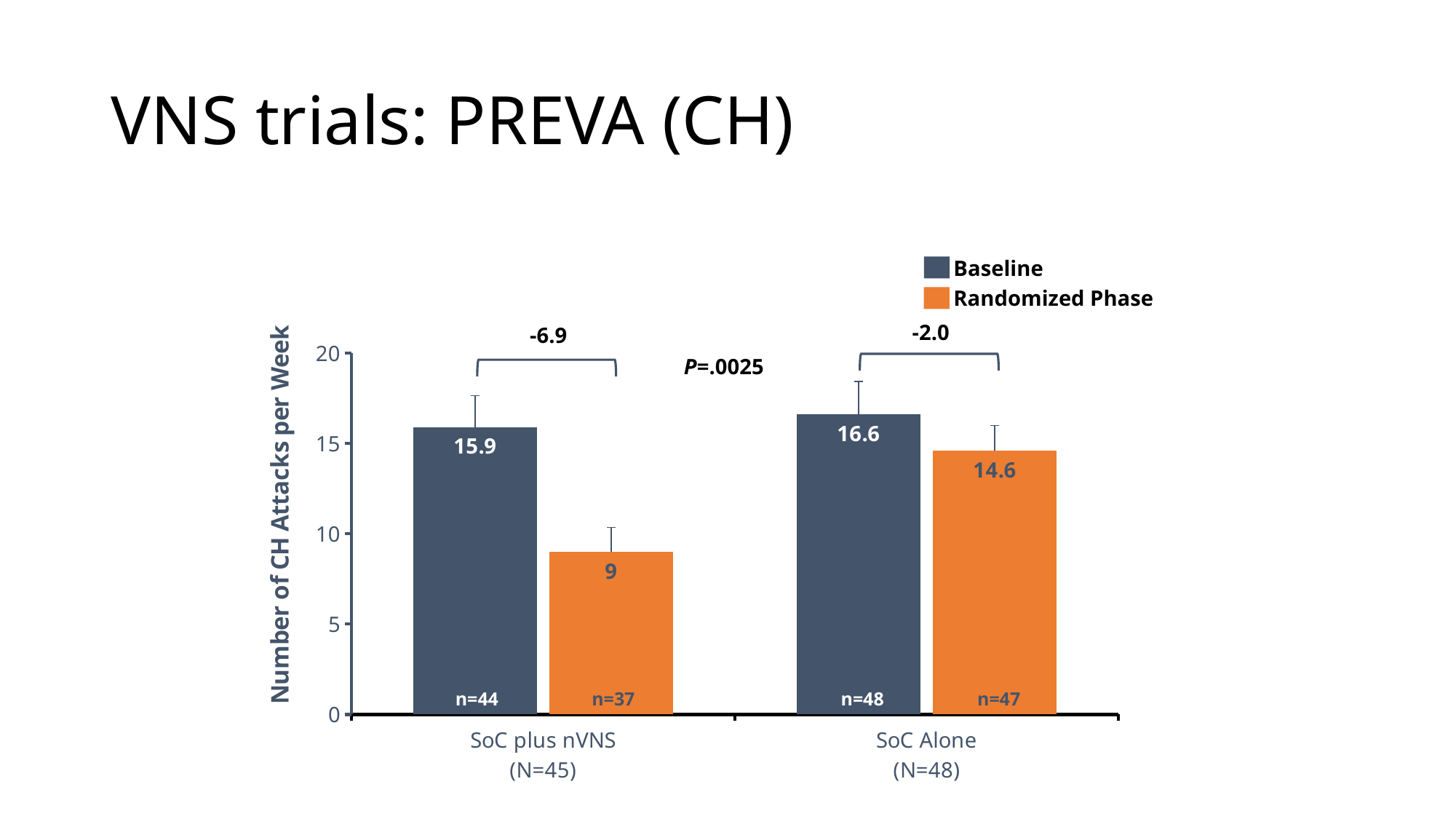
What is the Baseline value for SoC Alone? 16.6 How many series does the legend list? 2 How many categories are shown on the x axis? 2 What is the y-axis label of the chart? Number of CH Attacks per Week Which bar has the lowest value on the chart? Randomized Phase for SoC plus nVNS What is the Randomized Phase value for SoC Alone? 14.6 What is the Baseline value for SoC plus nVNS? 15.9 What is the difference between the Baseline and Randomized Phase values for SoC plus nVNS? 6.9 Which is larger: the Randomized Phase value for SoC Alone or the Randomized Phase value for SoC plus nVNS? SoC Alone What kind of chart is shown on the slide? Bar chart Which bar has the highest value on the chart? Baseline for SoC Alone What is the Randomized Phase value for SoC plus nVNS? 9